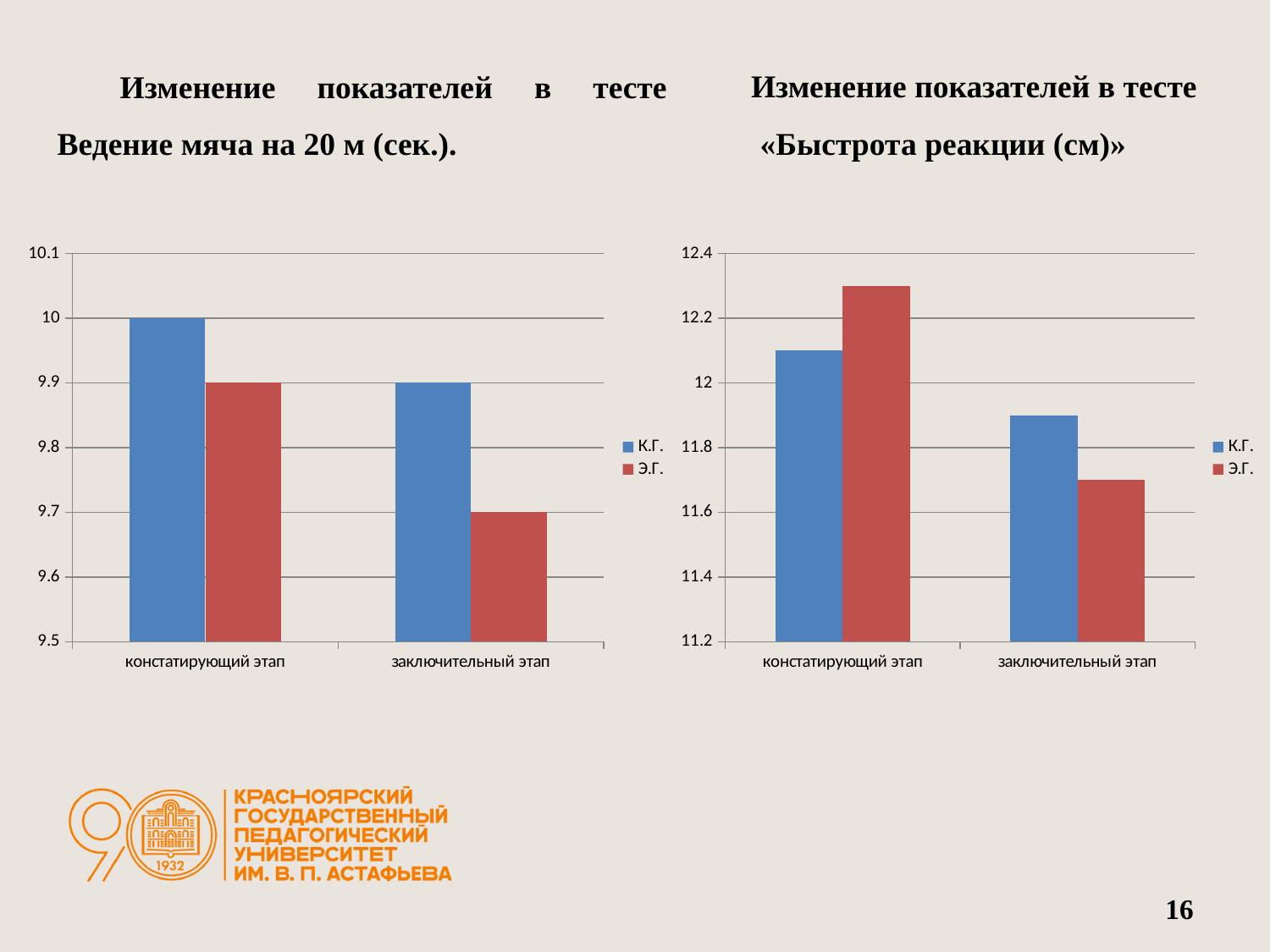
In the chart 'Ведение мяча на 20 м (сек.)', what is the difference between К.Г. and Э.Г. at the заключительный этап? 0.2 In the chart 'Ведение мяча на 20 м (сек.)', which series has the higher value at the констатирующий этап, К.Г. or Э.Г.? К.Г. What type of chart is the chart 'Ведение мяча на 20 м (сек.)'? bar chart In the chart 'Ведение мяча на 20 м (сек.)', what is the value for Э.Г. at the констатирующий этап? 9.9 In the chart 'Ведение мяча на 20 м (сек.)', does the Э.Г. value rise or fall from the констатирующий этап to the заключительный этап? fall In the chart 'Ведение мяча на 20 м (сек.)', what is the value for Э.Г. at the заключительный этап? 9.7 How many series does the legend of the chart 'Быстрота реакции (см)' list? 2 In the chart 'Быстрота реакции (см)', is the value for Э.Г. at the констатирующий этап greater or less than 12.2? greater In the chart 'Быстрота реакции (см)', which bar is the lowest? Э.Г. at the заключительный этап In the chart 'Быстрота реакции (см)', is the value for Э.Г. at the заключительный этап greater or less than 11.8? less In the chart 'Быстрота реакции (см)', which series has the higher value at the констатирующий этап, К.Г. or Э.Г.? Э.Г. In the chart 'Ведение мяча на 20 м (сек.)', what is the value for К.Г. at the констатирующий этап? 10